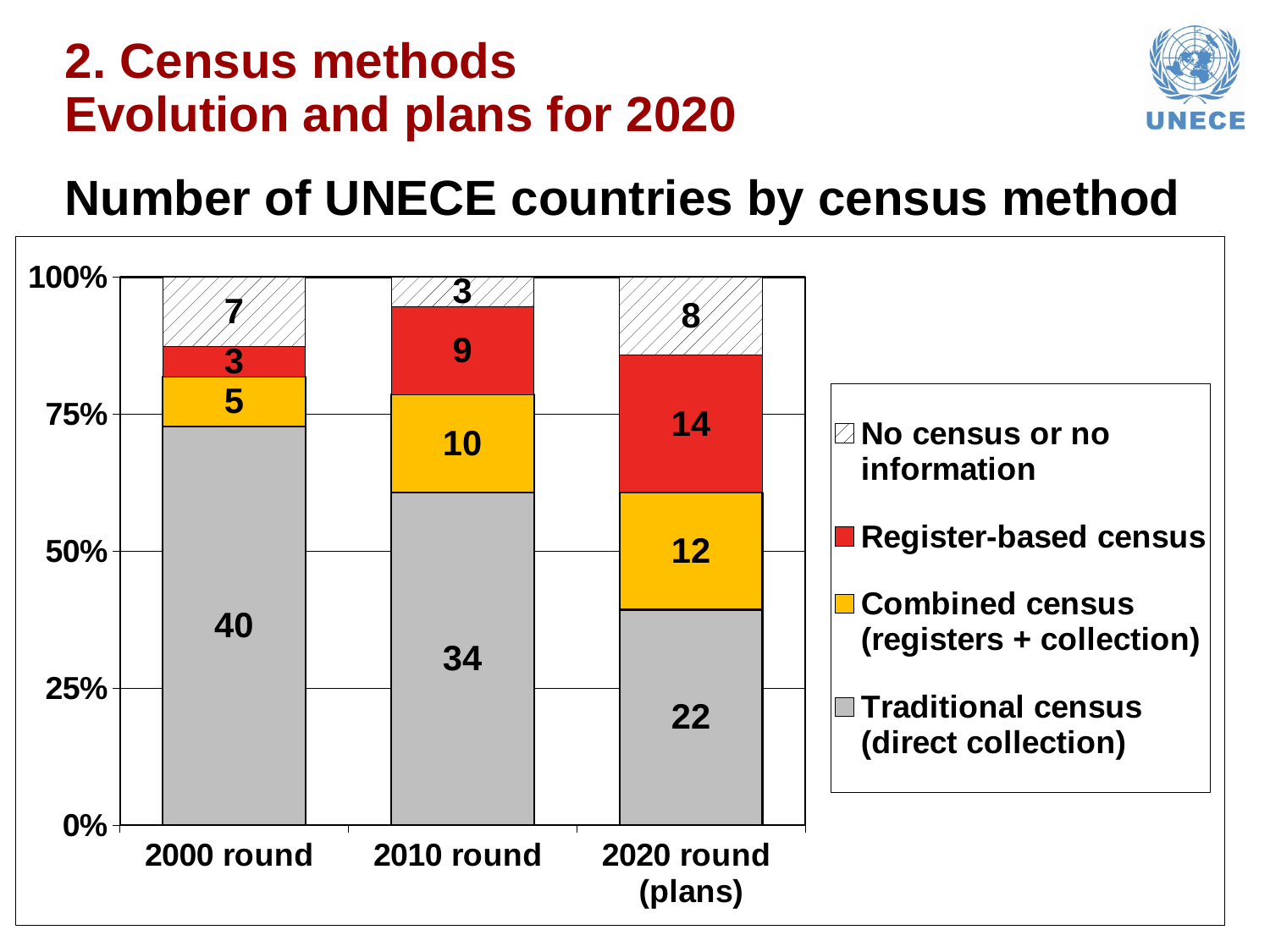
How many series does the legend list? 4 How many census rounds are shown on the x axis? 3 How many countries plan a register-based census for the 2020 round? 14 Which is larger in the 2010 round: the number of combined censuses or the number of register-based censuses? Combined census In which census round is the number of register-based censuses the highest? 2020 round (plans) How many UNECE countries used a traditional census (direct collection) in the 2000 round? 40 What kind of chart is shown on the slide? Stacked bar chart In which census round is the number of countries with a traditional census the lowest? 2020 round (plans) How many countries used a combined census (registers + collection) in the 2010 round? 10 Does the number of countries using a traditional census rise or fall from the 2000 round to the 2020 round? Fall What is the total number of countries across all four categories in the 2020 round (plans)? 56 What is the difference between the number of traditional censuses in the 2000 round and the 2020 round (plans)? 18